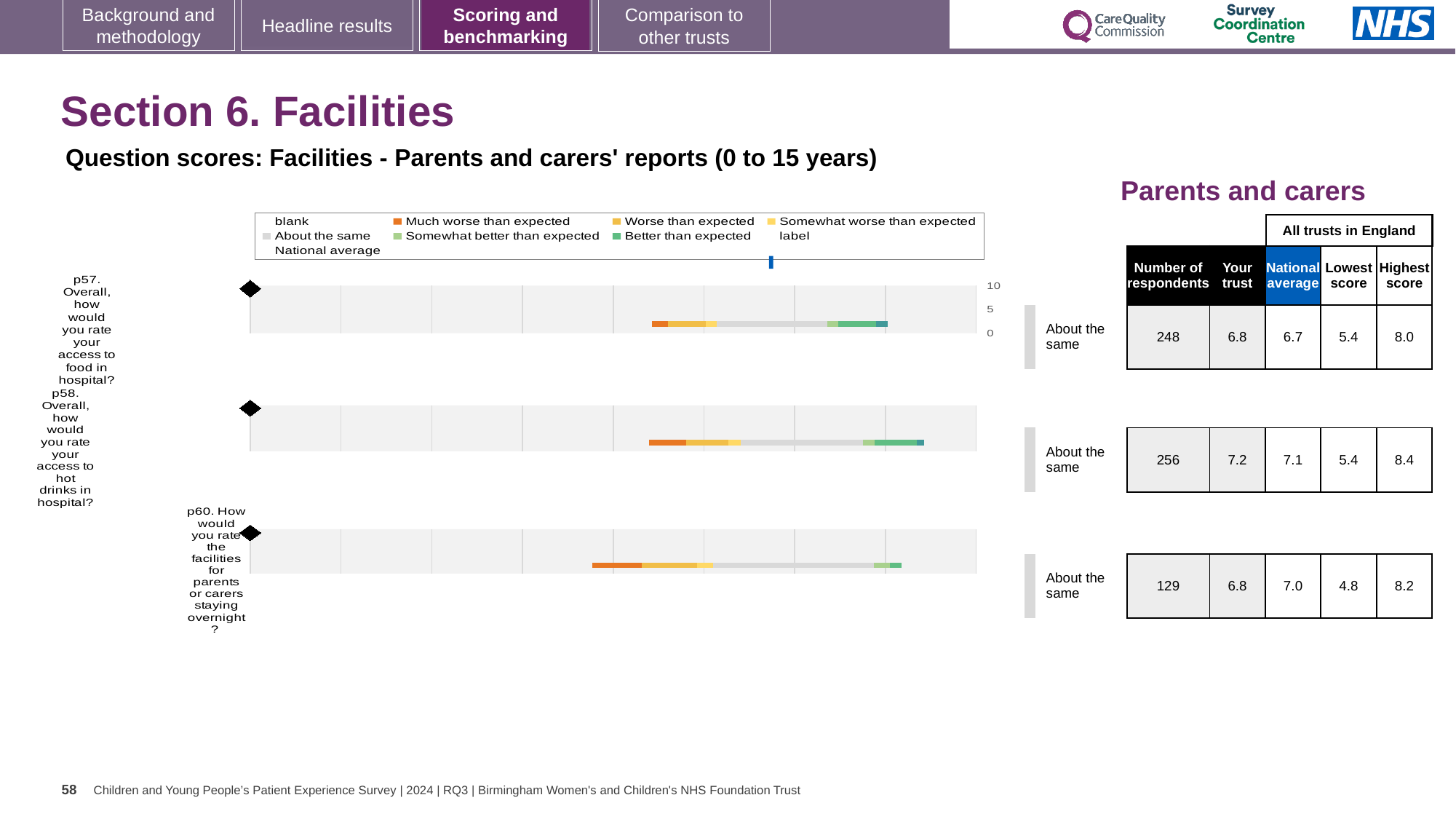
What is the maximum value shown on the chart's score axis? 10 Which of the three questions has the highest 'Highest score' in the table? p58 In the table beside the chart, what is the 'Your trust' score for p57 (access to food in hospital)? 6.8 In the table beside the chart, what is the national average for p58 (access to hot drinks in hospital)? 7.1 What benchmark category is given for all three questions next to the chart? About the same How many survey questions (categories) are plotted in the chart? 3 For p58, is the 'Your trust' score larger or smaller than the national average? larger Which legend entry is shown in orange? Much worse than expected What is the difference between the highest score and the lowest score for p60 in the table? 3.4 Which of the three questions has the lowest number of respondents in the table? p60 In the table beside the chart, how many respondents answered p60 (facilities for parents or carers staying overnight)? 129 What kind of chart is shown on the slide? bar chart